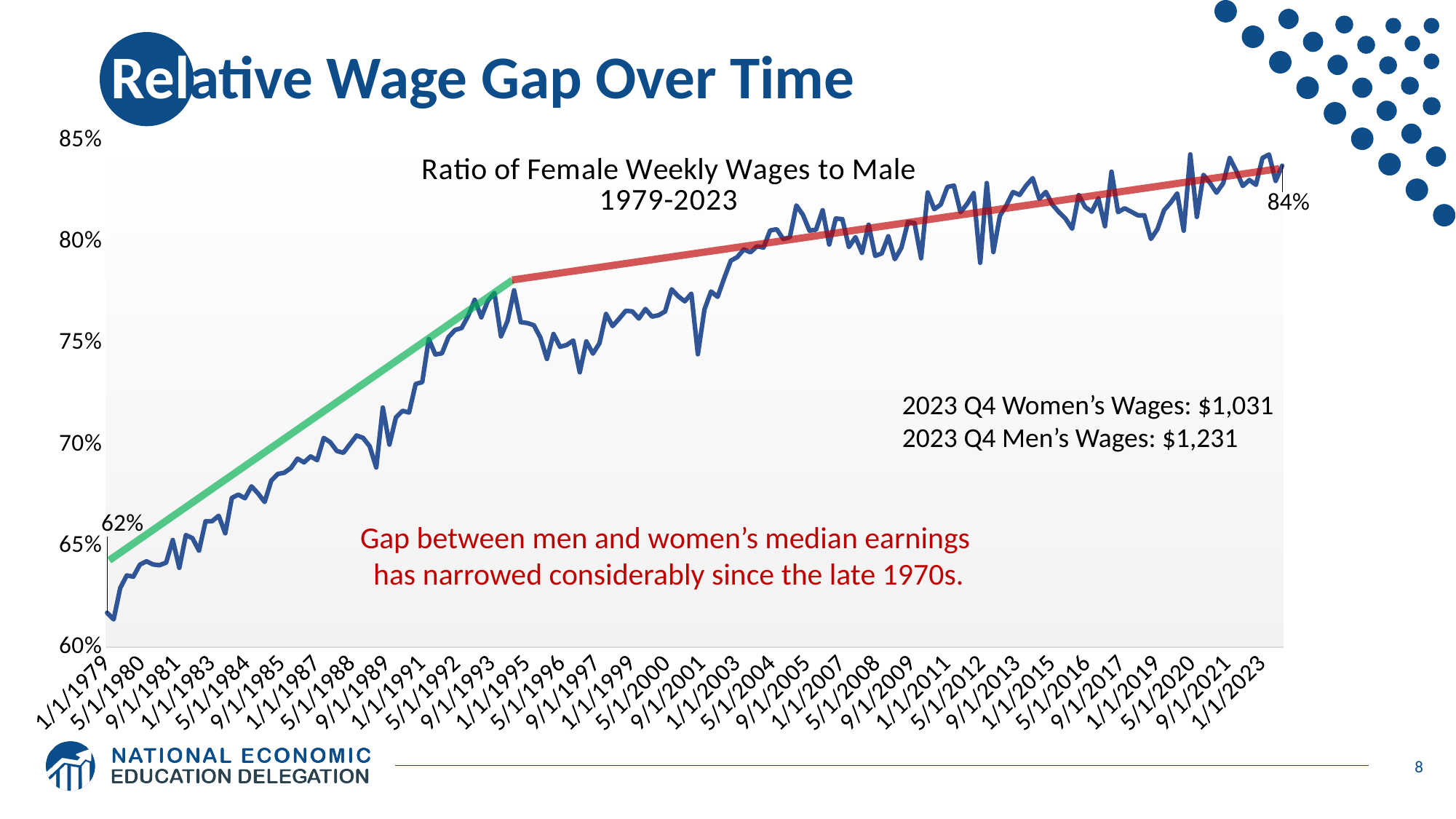
According to the annotation on the chart, what were women's weekly wages in 2023 Q4? $1,031 What is the ratio of female weekly wages to male at the end of the series, 1/1/2023? 84% Is the ratio of female weekly wages to male around 5/1/1985 greater or less than 70%? less Is the ratio of female weekly wages to male around 1/1/2000 greater or less than 75%? greater By how many percentage points did the ratio of female to male weekly wages rise between the labelled 1979 value and the labelled 2023 value? 22 percentage points Is the ratio of female weekly wages to male around 1/1/2016 greater or less than 80%? greater What kind of chart is shown on the slide? line chart Does the ratio of female weekly wages to male generally rise or fall from 1979 to 2023? rise Which is larger, the labelled ratio in 1979 or the labelled ratio in 2023? 2023 What is the title of the chart? Ratio of Female Weekly Wages to Male 1979-2023 What are the lowest and highest values shown on the chart's vertical axis? 60% and 85% What is the ratio of female weekly wages to male at the start of the series, 1/1/1979? 62%